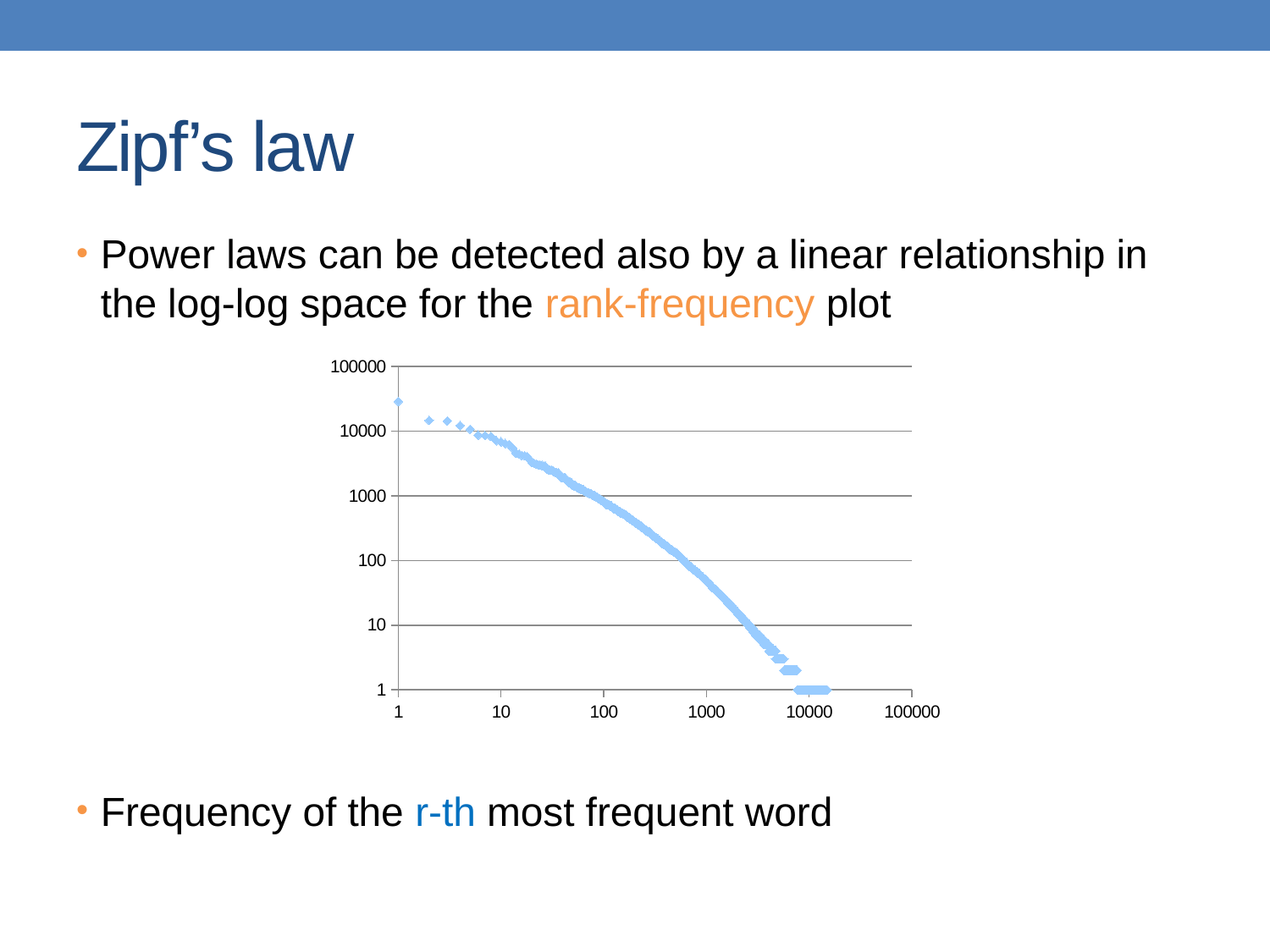
How many data series are plotted in the chart? 1 Is the frequency plotted at rank 10000 greater or less than 10? less What is the highest value labelled on the y axis? 100000 How many tick labels are shown on the x axis? 6 Is the frequency plotted at rank 1 greater or less than 10000? greater What is the lowest frequency value reached by the plotted points? 1 Do the plotted frequency values rise or fall as rank increases along the x axis? fall What is the highest value labelled on the x axis? 100000 What kind of chart is shown on the slide? scatter chart Is the frequency plotted at rank 1000 greater or less than 100? less At which rank is the highest frequency plotted? 1